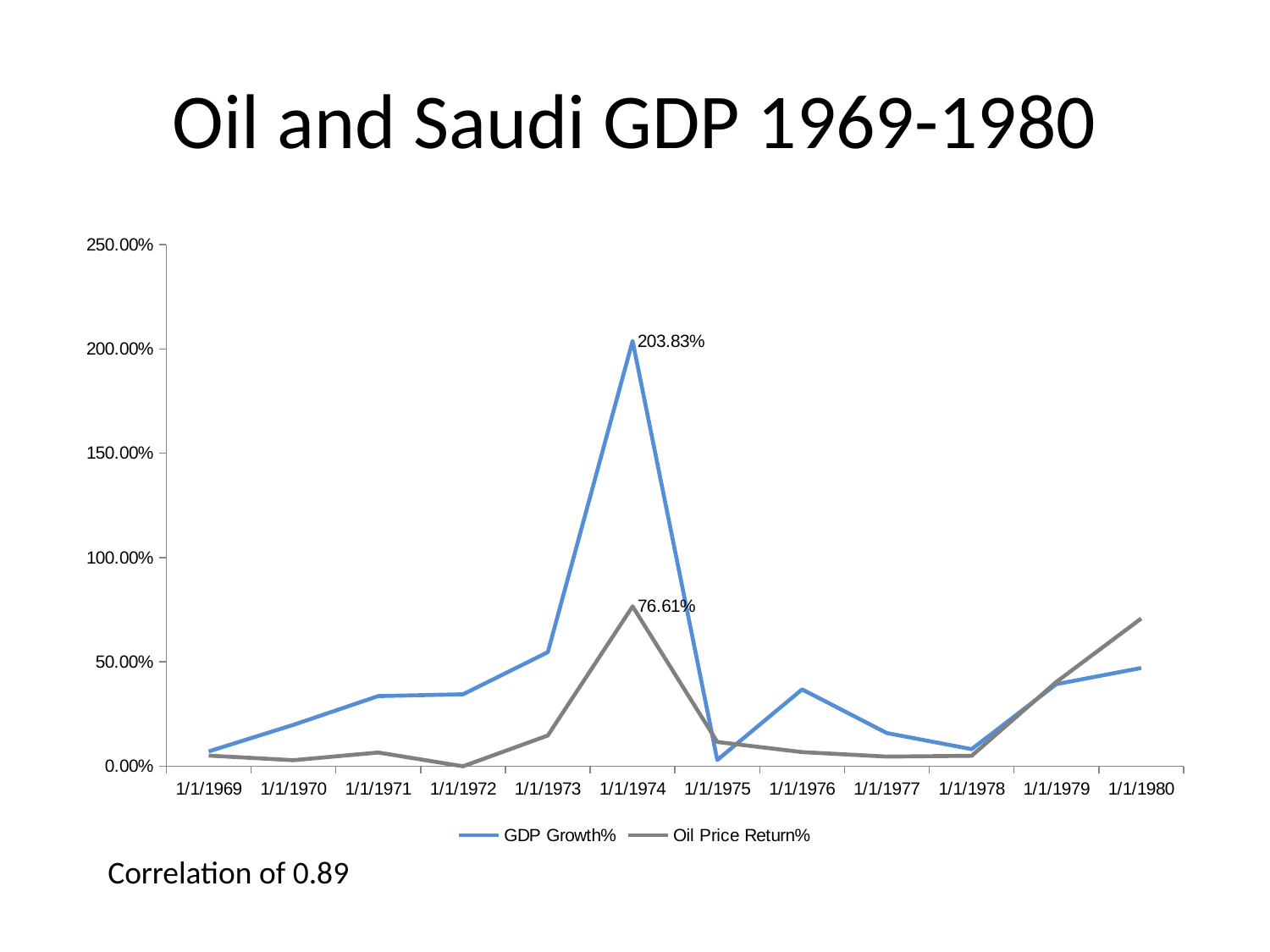
At 1/1/1980, which series has the higher value, GDP Growth% or Oil Price Return%? Oil Price Return% In which year does Oil Price Return% reach its highest value? 1/1/1974 What is the Oil Price Return% value at 1/1/1974? 76.61% What is the difference between GDP Growth% and Oil Price Return% at 1/1/1974? 127.22% How many dates are shown on the x axis? 12 What correlation value is stated below the chart? 0.89 How many series does the legend list? 2 In which year does GDP Growth% reach its highest value? 1/1/1974 What is the GDP Growth% value at 1/1/1974? 203.83% What kind of chart is shown on the slide? Line chart Is the GDP Growth% value at 1/1/1976 greater or less than 50.00%? less Is the Oil Price Return% value at 1/1/1980 greater or less than 50.00%? greater